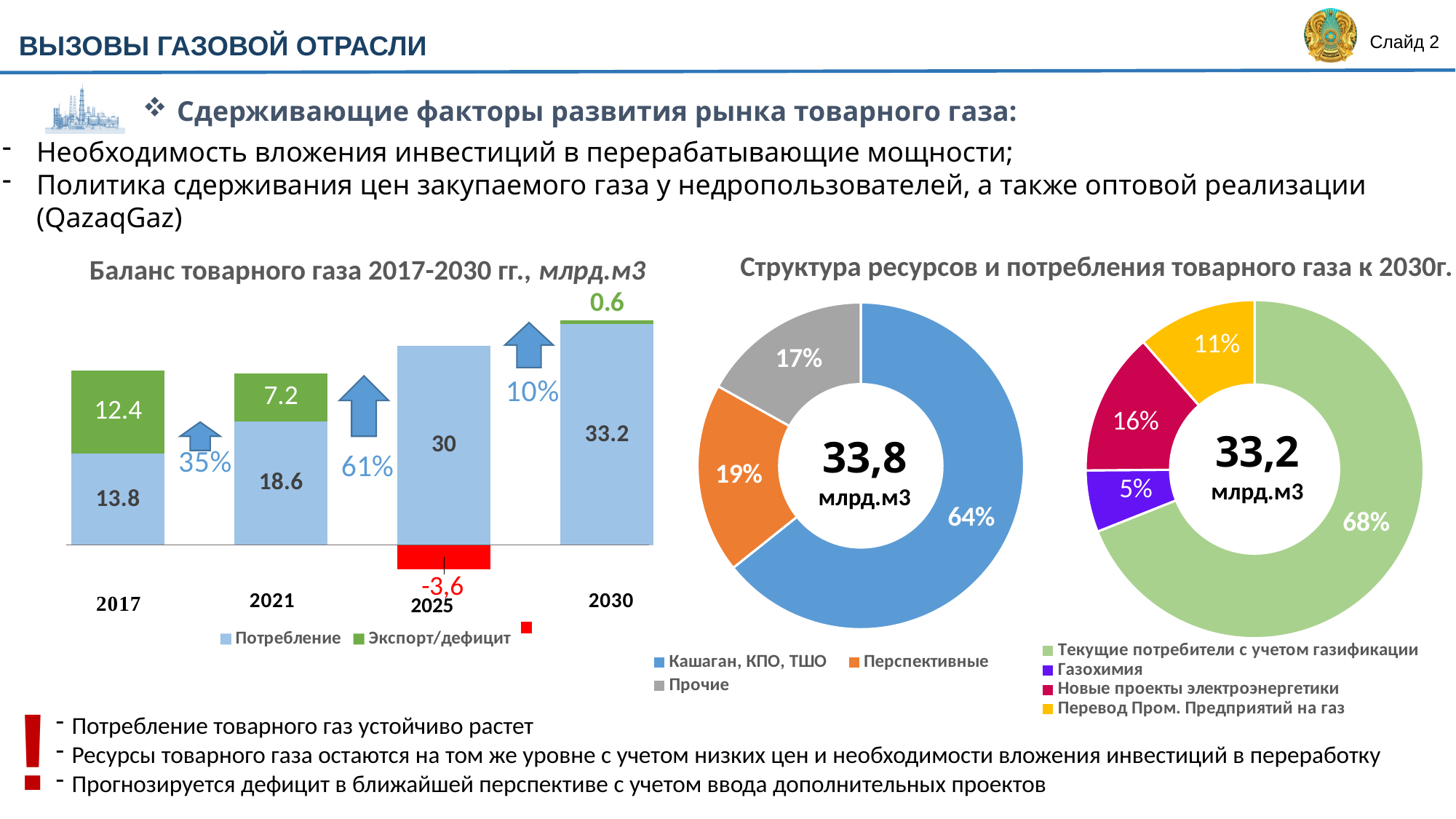
In the bar chart 'Баланс товарного газа 2017-2030 гг.', what is the total of the 2017 stacked bar (Потребление plus Экспорт/дефицит)? 26.2 In the left donut chart (33,8 млрд.м3), what share is Кашаган, КПО, ТШО? 64% How many categories does the legend of the right donut chart (33,2 млрд.м3) list? 4 In the bar chart 'Баланс товарного газа 2017-2030 гг.', which year has the highest Потребление value? 2030 In the bar chart 'Баланс товарного газа 2017-2030 гг.', what is the value of Потребление for 2030? 33.2 In the right donut chart (33,2 млрд.м3), what share is Новые проекты электроэнергетики? 16% In the bar chart 'Баланс товарного газа 2017-2030 гг.', what is the difference between Потребление in 2025 and in 2021? 11.4 In the bar chart 'Баланс товарного газа 2017-2030 гг.', what is the value of Потребление for 2017? 13.8 In the left donut chart (33,8 млрд.м3), which category has the smallest share? Прочие In the bar chart 'Баланс товарного газа 2017-2030 гг.', what is the value of Экспорт/дефицит for 2021? 7.2 In the bar chart 'Баланс товарного газа 2017-2030 гг.', does Потребление rise or fall from 2017 to 2030? rise In the bar chart 'Баланс товарного газа 2017-2030 гг.', what is the red value shown for 2025? -3,6